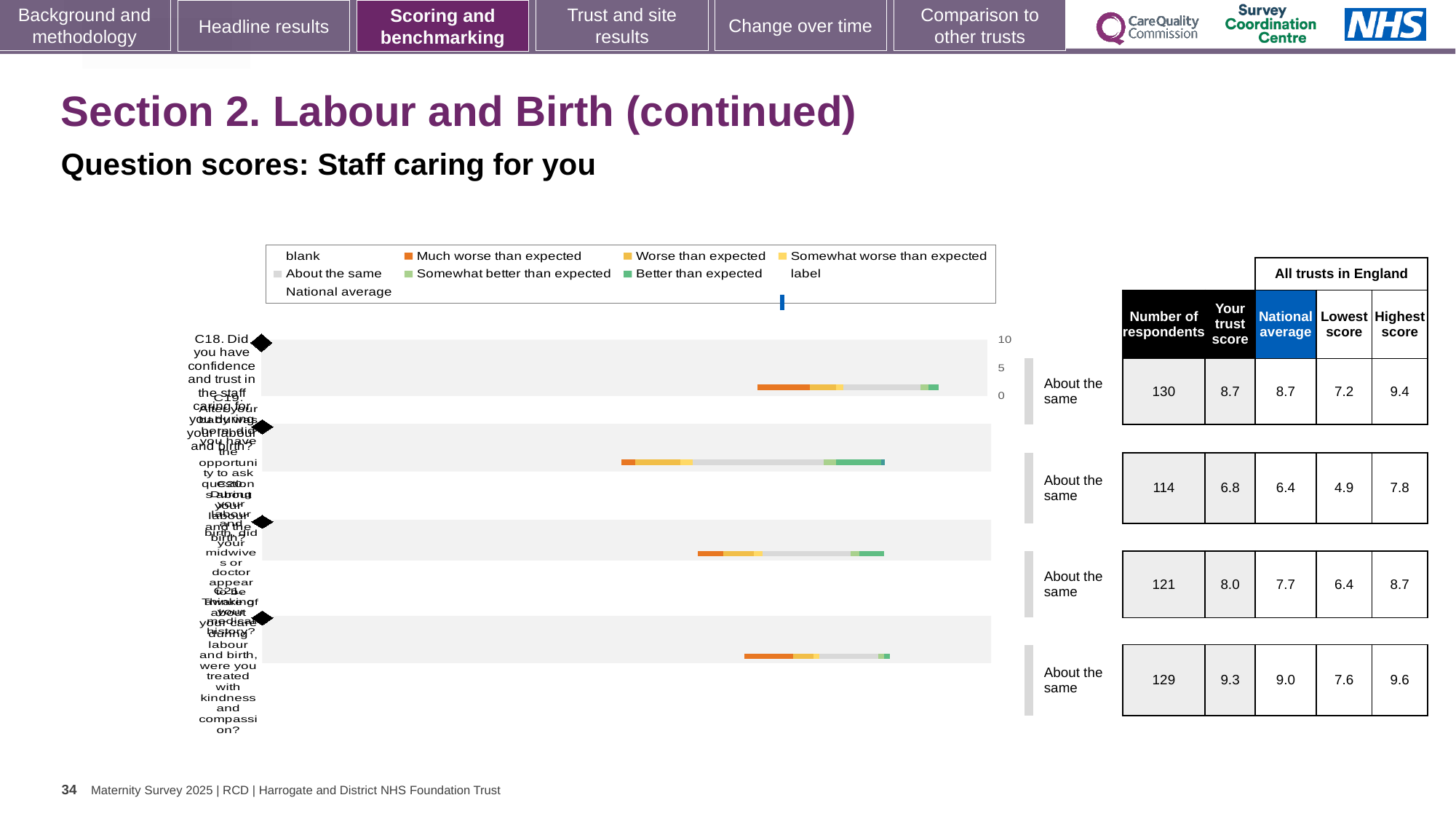
In the table beside the chart, what is the difference between the trust score and the national average in the second row (C19)? 0.4 In the table beside the chart, is the trust score in the fourth row (C21) larger or smaller than the national average in that row? larger In the chart legend, what colour represents 'Much worse than expected'? orange In the table beside the chart, what is the highest score in the fourth row (C21)? 9.6 What is the highest value shown on the chart's numeric axis? 10 What kind of chart is shown on the slide? bar chart How many questions (bars) are plotted in the chart? 4 In the table beside the chart, which row has the highest 'Your trust score'? fourth row (C21), 9.3 In the table beside the chart, what is the number of respondents in the first row (C18)? 130 In the table beside the chart, what is the national average in the third row (C20)? 7.7 In the table beside the chart, what is the 'Your trust score' value in the second row (C19)? 6.8 In the table beside the chart, which row has the lowest 'Lowest score' value? second row (C19), 4.9